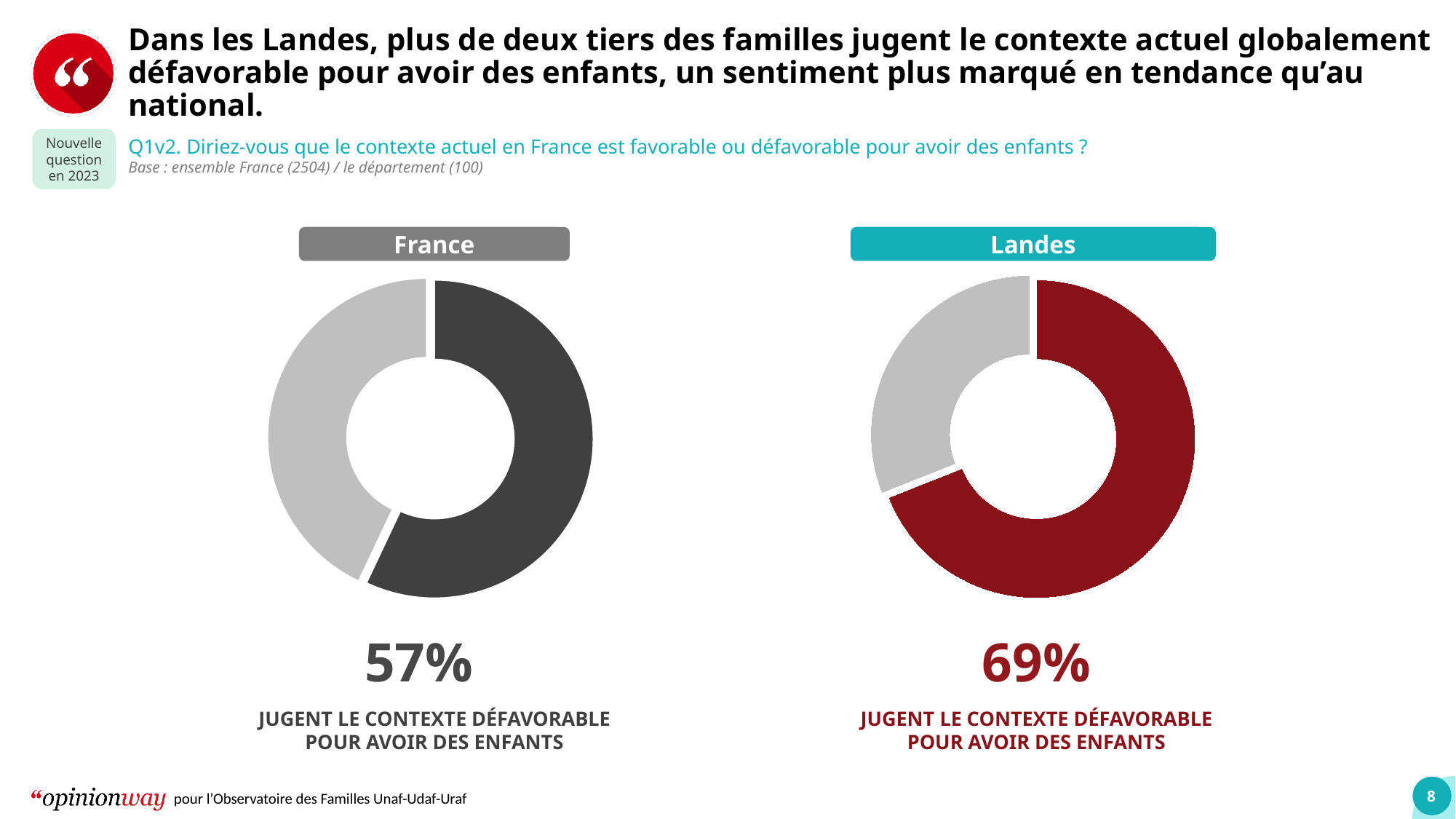
What colour is the slice representing 69% in the Landes chart? dark red In the France chart, what share of the pie does the dark grey slice represent? 57% Which chart shows the lower share judging the context unfavourable? France Is the Landes value for judging the context unfavourable greater or less than 50%? greater Which chart shows the higher share judging the context unfavourable, France or Landes? Landes What is the title shown above the left chart? France What kind of chart is used for the France and Landes figures? pie chart (donut) How many slices does the Landes chart have? 2 In the Landes chart, what share of the pie does the dark red slice represent? 69% In the France chart, what percentage judge the context unfavourable for having children? 57% What is the difference in percentage points between the Landes value (69%) and the France value (57%)? 12 points In the Landes chart, what percentage judge the context unfavourable for having children? 69%